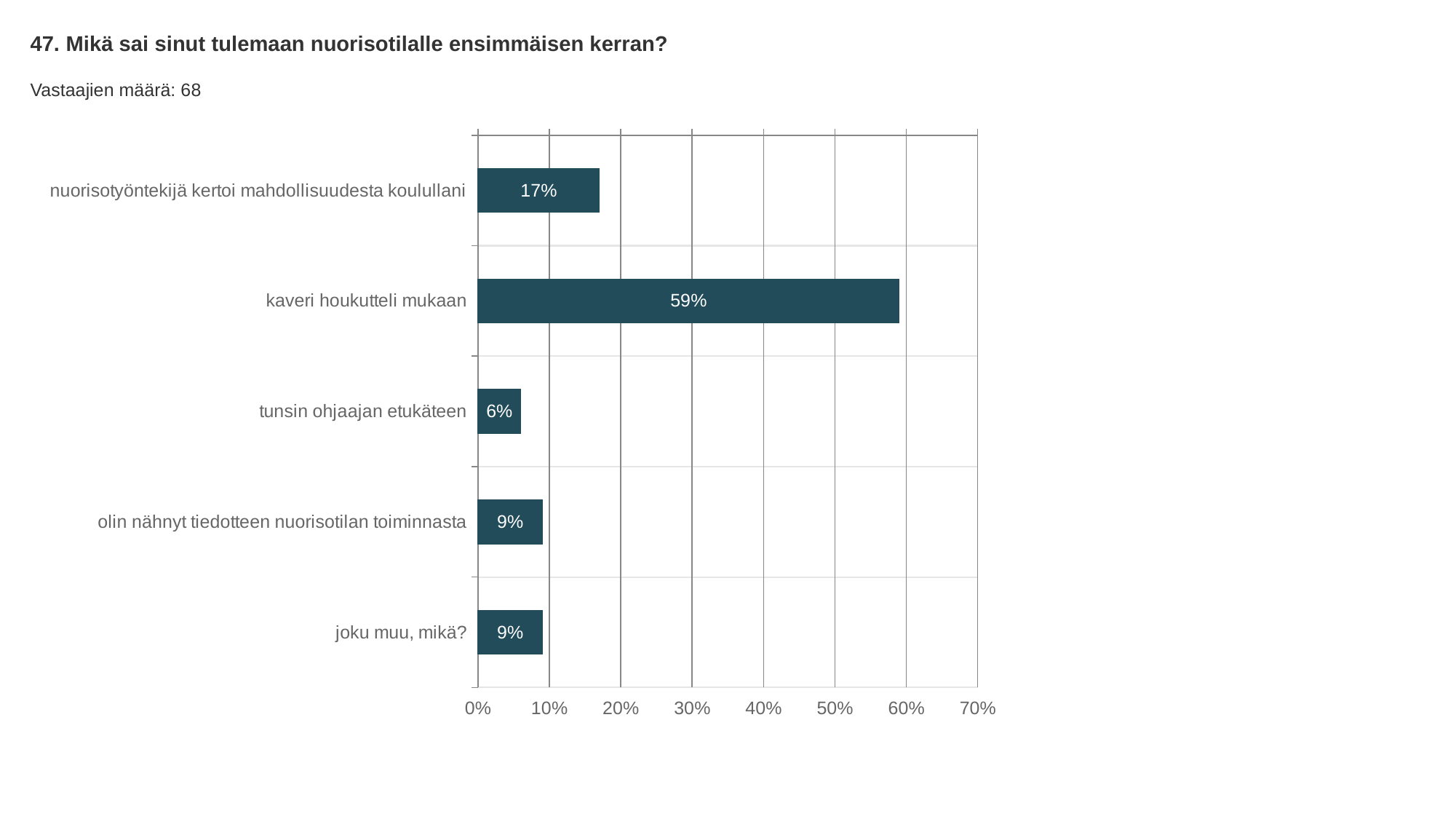
Which category has the lowest percentage? tunsin ohjaajan etukäteen How many respondents (Vastaajien määrä) are reported on the slide? 68 Which is larger, the value for "nuorisotyöntekijä kertoi mahdollisuudesta koulullani" or the value for "joku muu, mikä?"? nuorisotyöntekijä kertoi mahdollisuudesta koulullani Is the value for "kaveri houkutteli mukaan" greater or less than 50%? greater What is the difference in percentage points between "kaveri houkutteli mukaan" and "nuorisotyöntekijä kertoi mahdollisuudesta koulullani"? 42 Which category has the highest percentage? kaveri houkutteli mukaan What kind of chart is shown on the slide? bar chart What percentage is shown for "nuorisotyöntekijä kertoi mahdollisuudesta koulullani"? 17% What percentage is shown for "kaveri houkutteli mukaan"? 59% How many categories are shown in the chart? 5 What percentage is shown for "olin nähnyt tiedotteen nuorisotilan toiminnasta"? 9% What percentage is shown for "tunsin ohjaajan etukäteen"? 6%